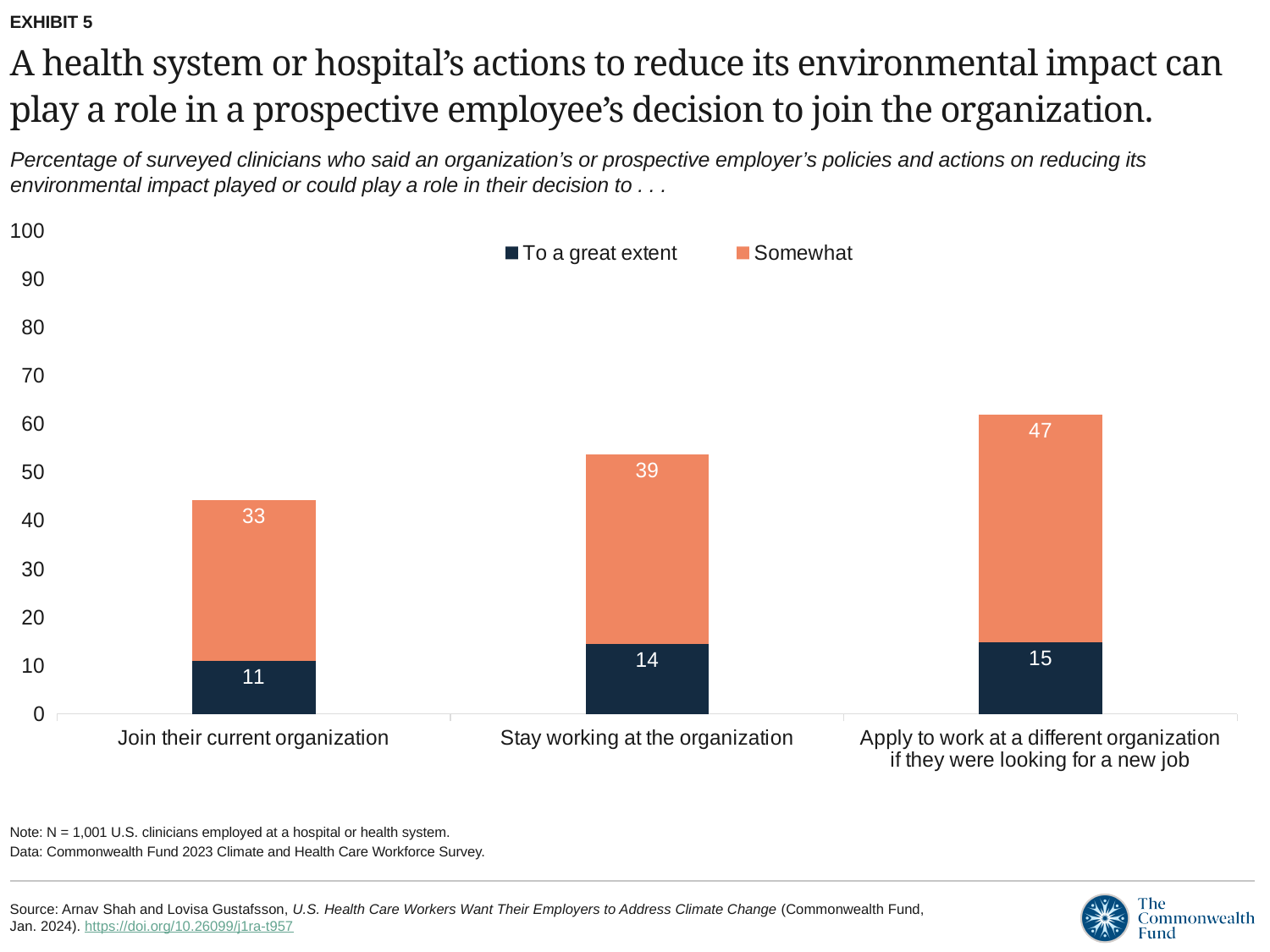
Which is larger: the "To a great extent" value for "Stay working at the organization" or for "Join their current organization"? Stay working at the organization How many categories are shown on the x axis? 3 Which category has the lowest "Somewhat" value? Join their current organization How many series does the legend list? 2 Which category has the highest "To a great extent" value? Apply to work at a different organization if they were looking for a new job Is the total stacked bar for "Apply to work at a different organization if they were looking for a new job" greater or less than 60? greater What is the total of the stacked bar for "Stay working at the organization"? 53 What is the "Somewhat" value for "Apply to work at a different organization if they were looking for a new job"? 47 What is the difference between the "Somewhat" values for "Apply to work at a different organization if they were looking for a new job" and "Join their current organization"? 14 What kind of chart is shown on the slide? Stacked bar chart What is the "Somewhat" value for "Stay working at the organization"? 39 What is the "To a great extent" value for "Join their current organization"? 11